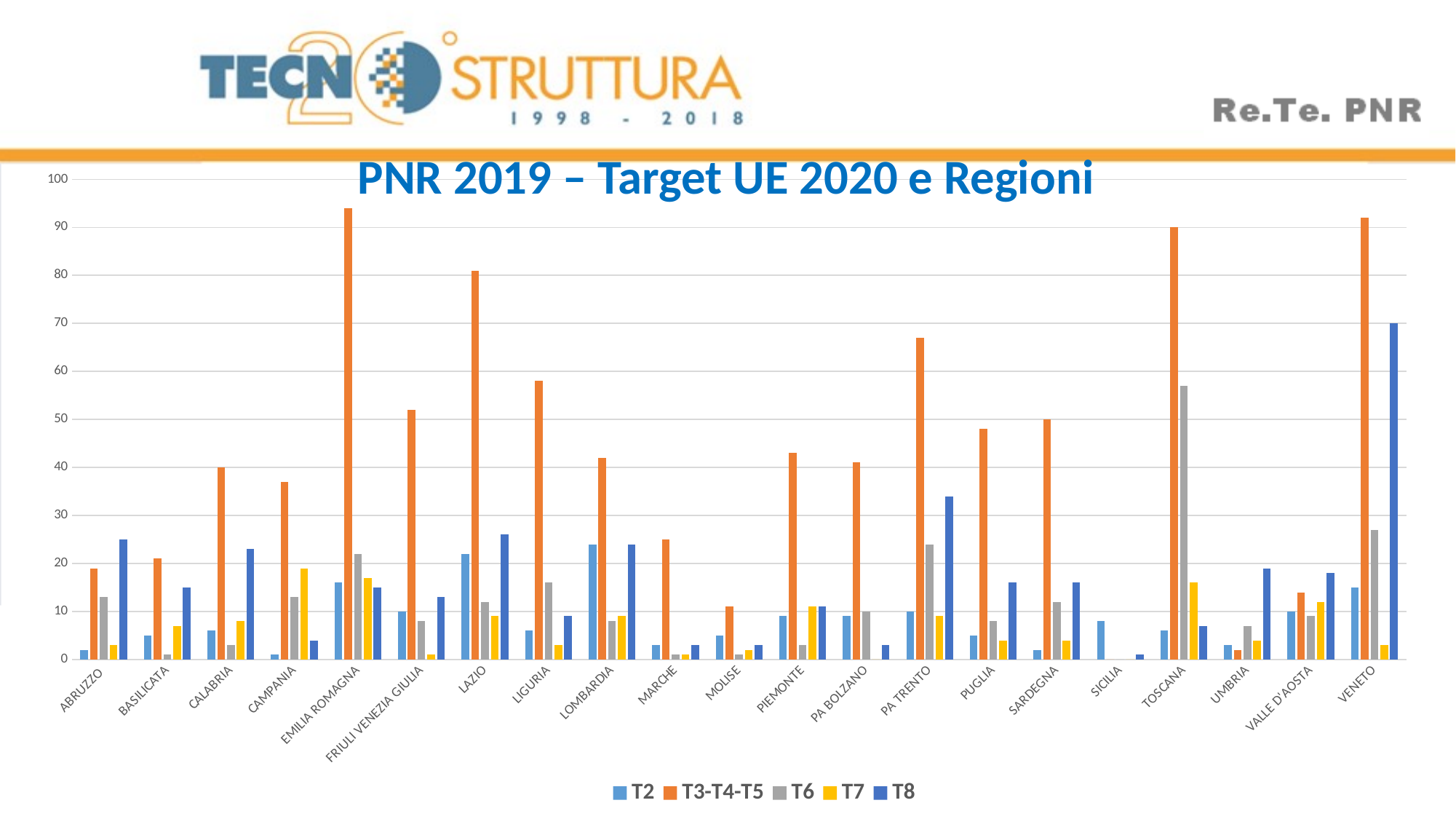
Is the T3-T4-T5 value for Emilia Romagna greater or less than 90? greater How many regions (categories) are shown on the x axis? 21 Which is larger, the T3-T4-T5 value for Lazio or for Liguria? Lazio What kind of chart is shown on the slide? Bar chart What is the T8 value for Veneto? 70 Is the T3-T4-T5 value for Piemonte greater or less than 50? less Which region has the highest T6 value? Toscana What is the title of the chart? PNR 2019 – Target UE 2020 e Regioni What is the T3-T4-T5 value for Toscana? 90 Which region has the highest T8 value? Veneto Which series is drawn in orange? T3-T4-T5 How many series does the legend list? 5